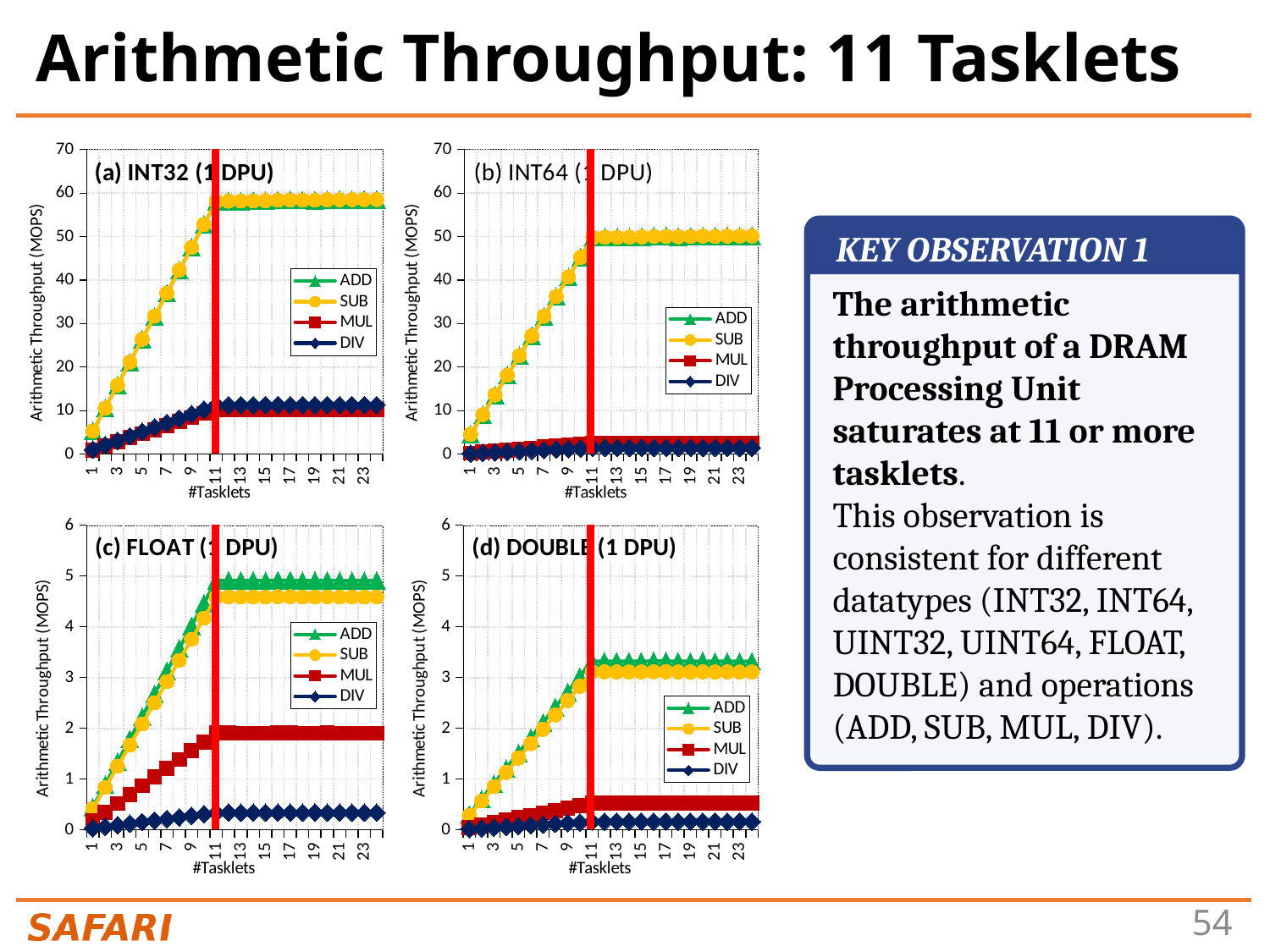
In the (c) FLOAT (1 DPU) chart, is the MUL value at 23 tasklets greater or less than 1? greater In the (a) INT32 (1 DPU) chart, is the ADD value at 23 tasklets greater or less than 50? greater In the (c) FLOAT (1 DPU) chart, which series has the lowest throughput at 23 tasklets? DIV In the (b) INT64 (1 DPU) chart, does the ADD throughput rise or fall as the number of tasklets increases from 1 to 11? rises How many series does the legend of the (b) INT64 (1 DPU) chart list? 4 What kind of chart is the (a) INT32 (1 DPU) chart? line chart What is the y-axis label of the (d) DOUBLE (1 DPU) chart? Arithmetic Throughput (MOPS) What are the legend entries in the (c) FLOAT (1 DPU) chart? ADD, SUB, MUL, DIV How many charts are shown on the slide? 4 In the (c) FLOAT (1 DPU) chart, which is larger at 23 tasklets, MUL or DIV? MUL In the (b) INT64 (1 DPU) chart, is the DIV value at 23 tasklets greater or less than 10? less